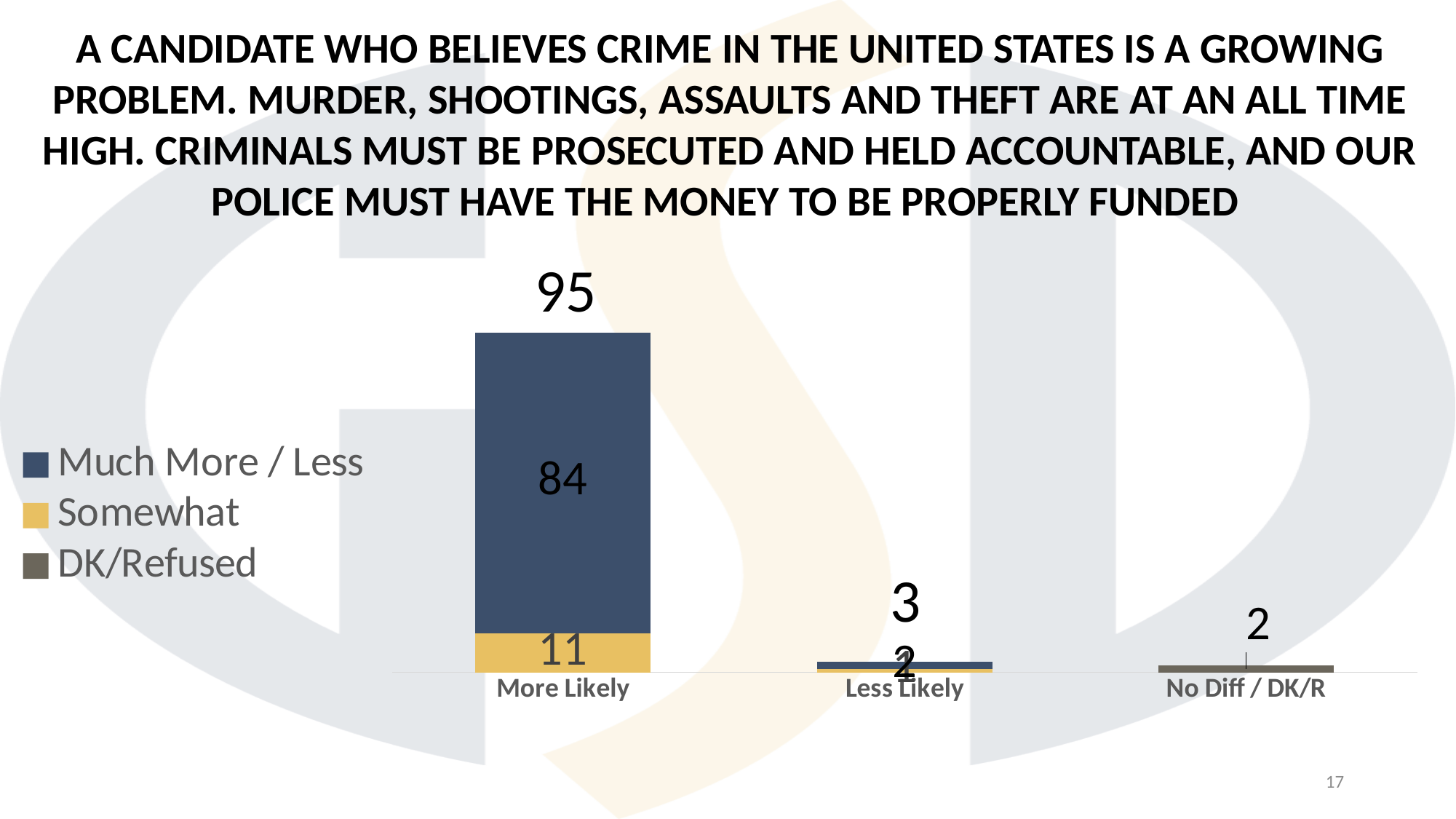
What value is shown for the No Diff / DK/R bar? 2 Within the More Likely bar, what is the difference between the Much More / Less value and the Somewhat value? 73 What is the total shown above the More Likely bar? 95 What is the Much More / Less value for the More Likely bar? 84 What is the total shown above the Less Likely bar? 3 Which category has the lowest total? No Diff / DK/R What is the difference between the More Likely total and the Less Likely total? 92 How many series does the legend list? 3 Which category has the highest total? More Likely What is the Somewhat value for the More Likely bar? 11 What kind of chart is shown on the slide? Stacked bar chart How many categories are shown on the x axis? 3